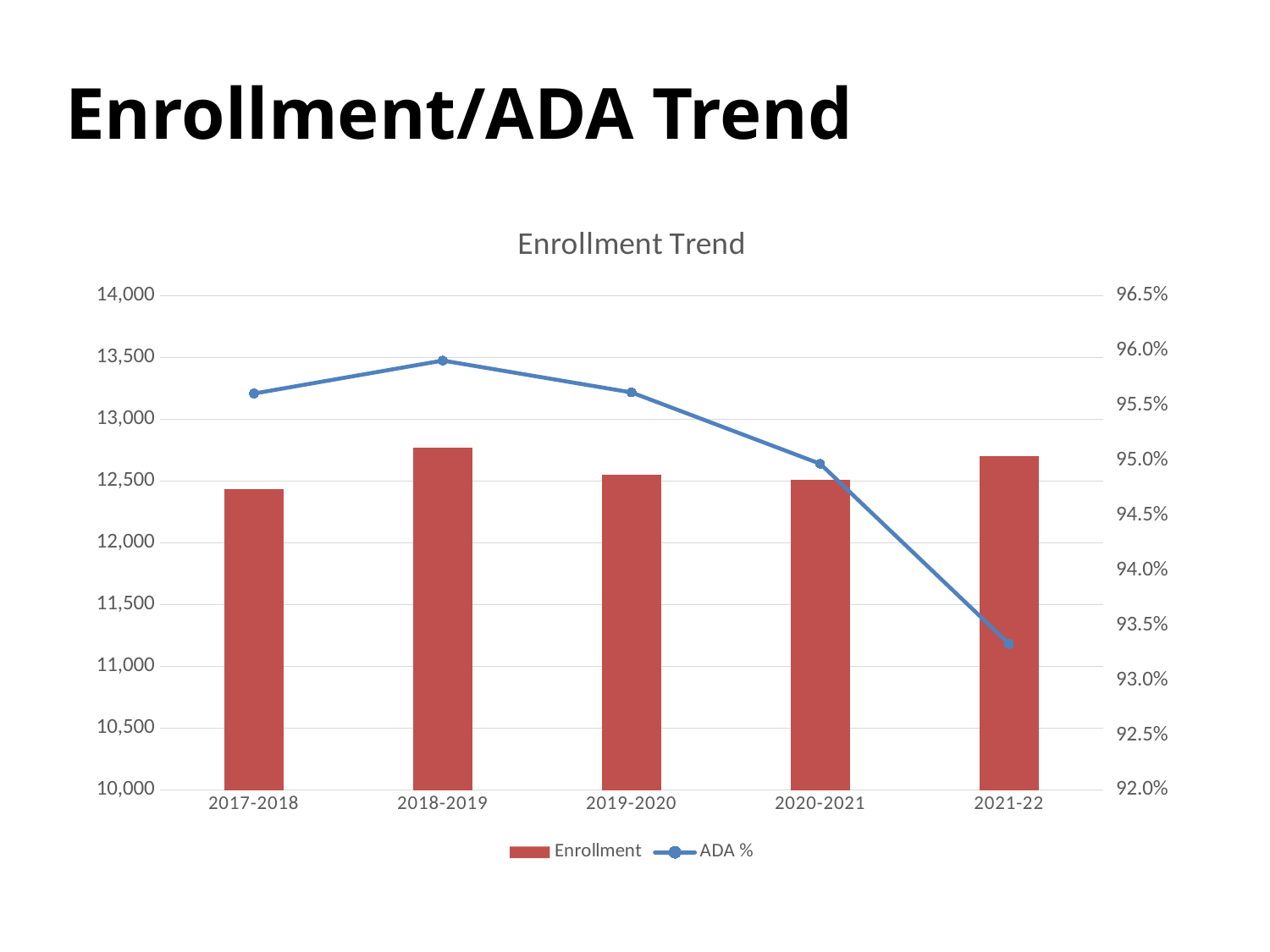
Which school year has the lowest ADA %? 2021-22 Is the ADA % for 2021-22 greater or less than 93.5%? less Which has the higher ADA %, 2018-2019 or 2020-2021? 2018-2019 How many series does the legend list? 2 How many school years are shown on the x axis? 5 What is the title of the chart? Enrollment Trend What kind of chart is shown on the slide? A combined bar and line chart Which school year has the highest ADA %? 2018-2019 Does the ADA % line rise or fall from 2018-2019 to 2021-22? fall Is the Enrollment value for 2018-2019 greater or less than 12,500? greater What are the two series named in the legend? Enrollment and ADA % Is the Enrollment value for 2017-2018 greater or less than 12,500? less